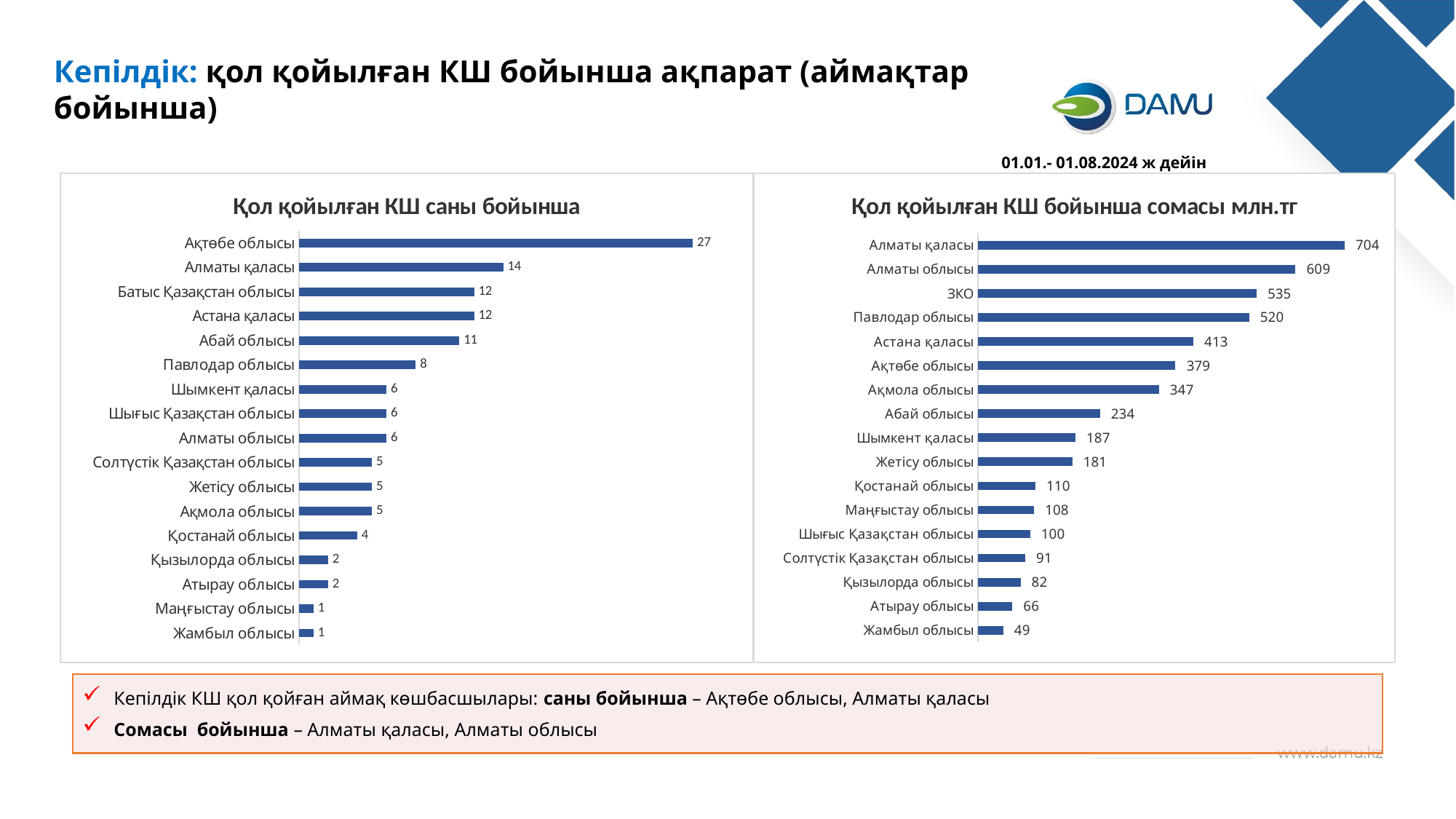
In the chart 'Қол қойылған КШ бойынша сомасы млн.тг', which category has the lowest value? Жамбыл облысы In the chart 'Қол қойылған КШ саны бойынша', what is the value for Павлодар облысы? 8 What is the title of the chart on the left side of the slide? Қол қойылған КШ саны бойынша In the chart 'Қол қойылған КШ саны бойынша', which category has the highest value? Ақтөбе облысы In the chart 'Қол қойылған КШ бойынша сомасы млн.тг', what is the difference between Алматы қаласы and Алматы облысы? 95 In the chart 'Қол қойылған КШ саны бойынша', how many categories are shown? 17 In the chart 'Қол қойылған КШ саны бойынша', what is the difference between Ақтөбе облысы and Алматы қаласы? 13 What type of chart is 'Қол қойылған КШ бойынша сомасы млн.тг'? Bar chart In the chart 'Қол қойылған КШ бойынша сомасы млн.тг', what is the value for Ақмола облысы? 347 In the chart 'Қол қойылған КШ бойынша сомасы млн.тг', which is larger: Павлодар облысы or Астана қаласы? Павлодар облысы In the chart 'Қол қойылған КШ бойынша сомасы млн.тг', what is the value for Алматы қаласы? 704 In the chart 'Қол қойылған КШ саны бойынша', what is the value for Ақтөбе облысы? 27